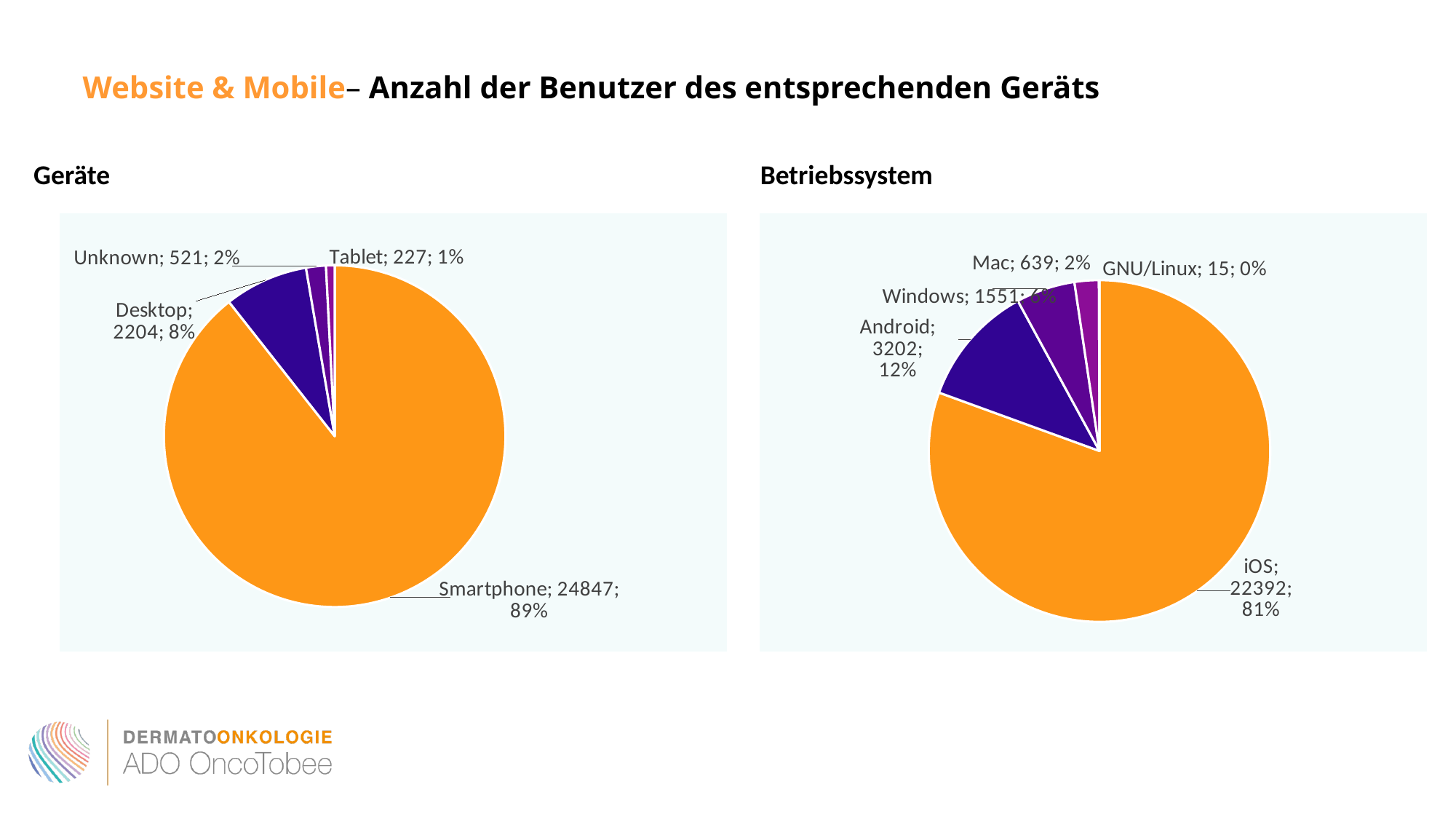
In the Geräte chart, which category has the smallest slice? Tablet In the Betriebssystem chart, how many users are shown for Android? 3202 In the Geräte chart, what share of the pie does Desktop have? 8% In the Betriebssystem chart, what is the difference between the iOS and Android values? 19190 How many categories does the Geräte pie chart show? 4 In the Betriebssystem chart, which is larger, Windows or Mac? Windows In the Geräte chart, how many users are shown for Smartphone? 24847 How many categories does the Betriebssystem pie chart show? 5 What type of chart is used for the Geräte data? Pie chart In the Geräte chart, what is the difference between the Desktop and Unknown values? 1683 In the Betriebssystem chart, what share of the pie does iOS have? 81% In the Betriebssystem chart, which category has the largest slice? iOS